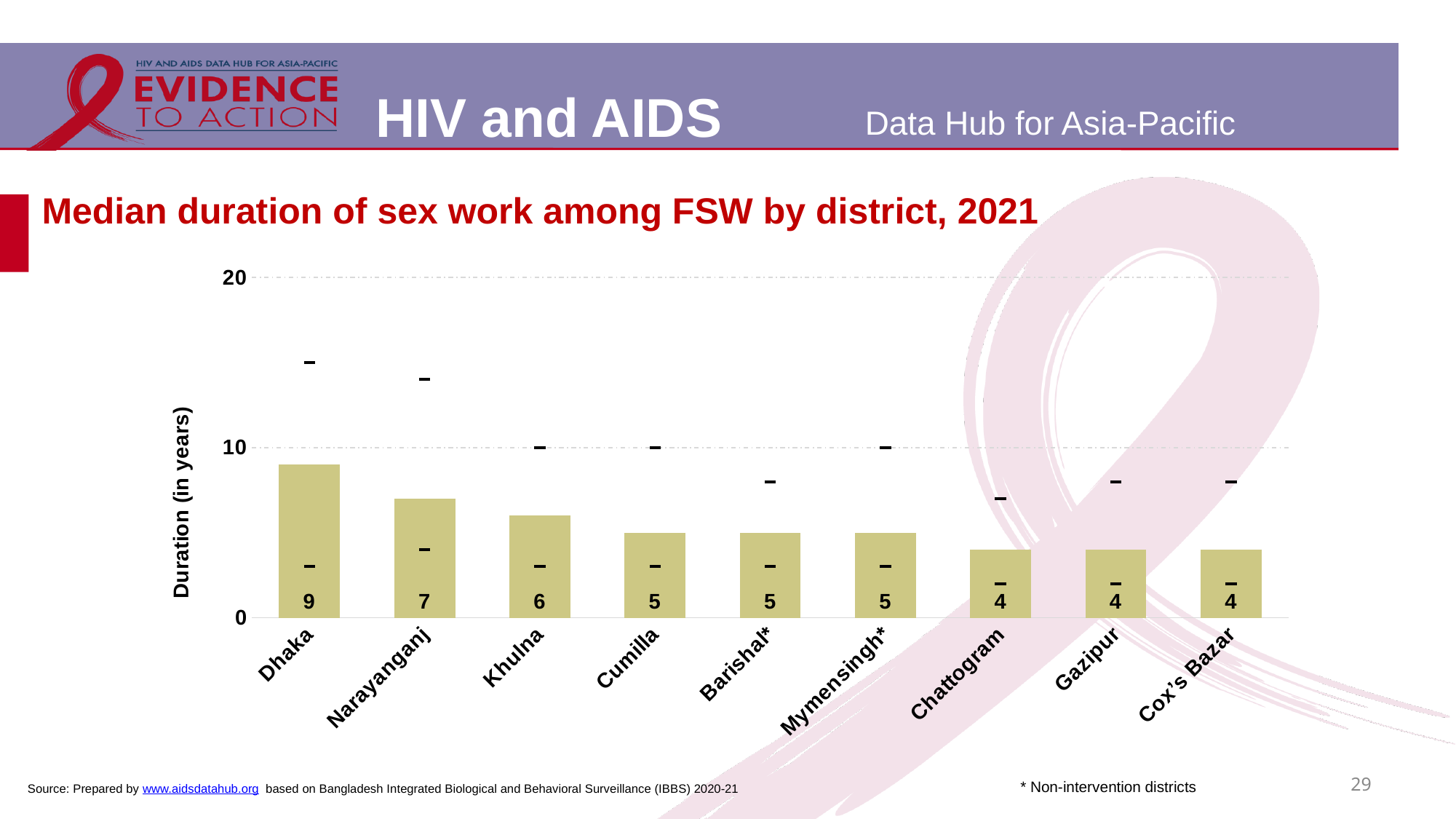
What is the median duration of sex work for Chattogram? 4 Which district has the highest median duration of sex work? Dhaka What is the difference between the median duration for Dhaka and for Cox's Bazar? 5 What is the difference between the median duration for Narayanganj and for Khulna? 1 What kind of chart is shown on the slide? Bar chart What is the median duration of sex work for Khulna? 6 What is the median duration of sex work for Dhaka? 9 Is the value for Dhaka greater or less than 10? less Which has a larger median duration, Khulna or Gazipur? Khulna How many districts are shown on the chart? 9 What is the label of the vertical axis? Duration (in years) What is the median duration of sex work for Narayanganj? 7